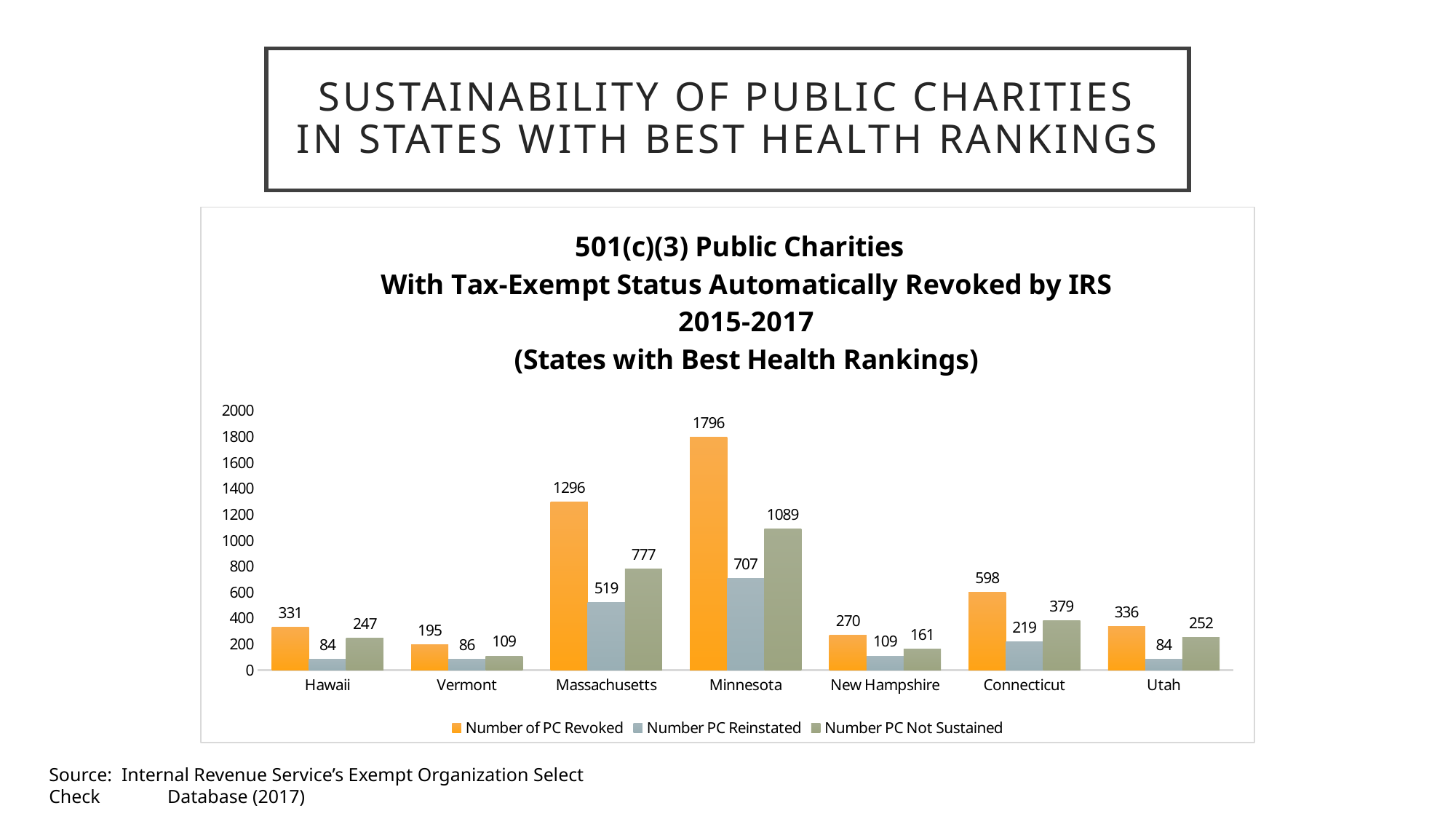
Is the Number of PC Revoked for Massachusetts greater or less than 1200? greater What is the difference between the Number of PC Revoked and the Number PC Reinstated for Minnesota? 1089 Which colour represents the Number of PC Revoked series? Orange What is the Number of PC Revoked for Minnesota? 1796 Which state has the lowest Number PC Not Sustained? Vermont What is the Number PC Not Sustained for Connecticut? 379 How many series does the legend list? 3 What is the Number PC Reinstated for Massachusetts? 519 What kind of chart is shown on the slide? Bar chart How many states are shown on the x axis? 7 Which state has the highest Number of PC Revoked? Minnesota Which is larger: the Number PC Not Sustained for Hawaii or for Utah? Utah